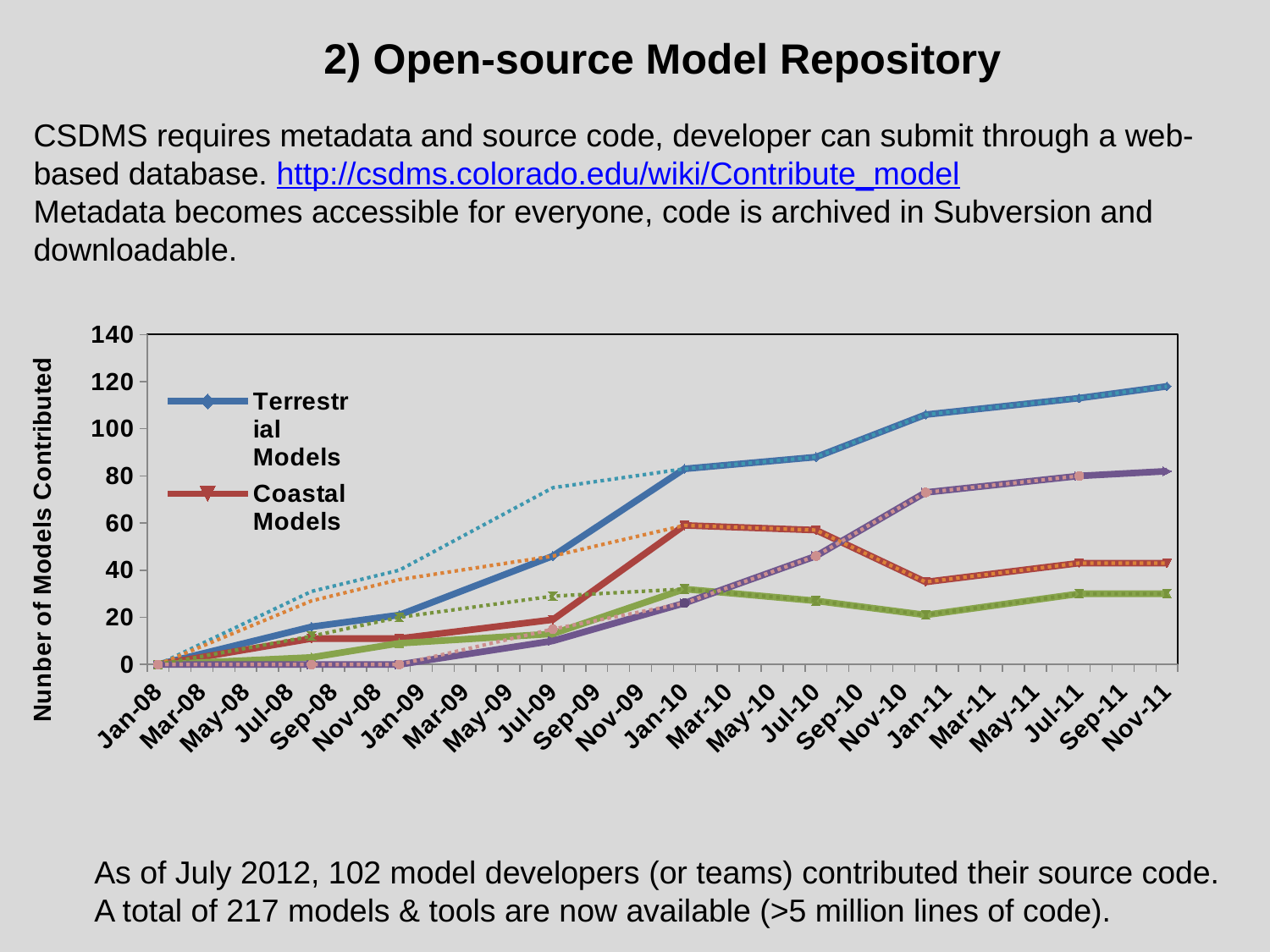
How many date labels are shown along the x axis of the chart? 24 Do the values for Terrestrial Models rise or fall from Jan-08 to Nov-11? rise Which two series are named in the chart legend? Terrestrial Models and Coastal Models Is the value for Terrestrial Models at Jan-10 greater or less than 60? greater What kind of chart is shown on the slide? line chart At Nov-11, which series has the larger value, Terrestrial Models or Coastal Models? Terrestrial Models What is the title of the vertical axis of the chart? Nunber of Models Contributed Which series has the highest value at Nov-11? Terrestrial Models How many series does the chart legend list? 2 Is the value for Coastal Models at Jan-11 greater or less than 20? greater Is the value for Coastal Models at Jan-10 greater or less than 40? greater